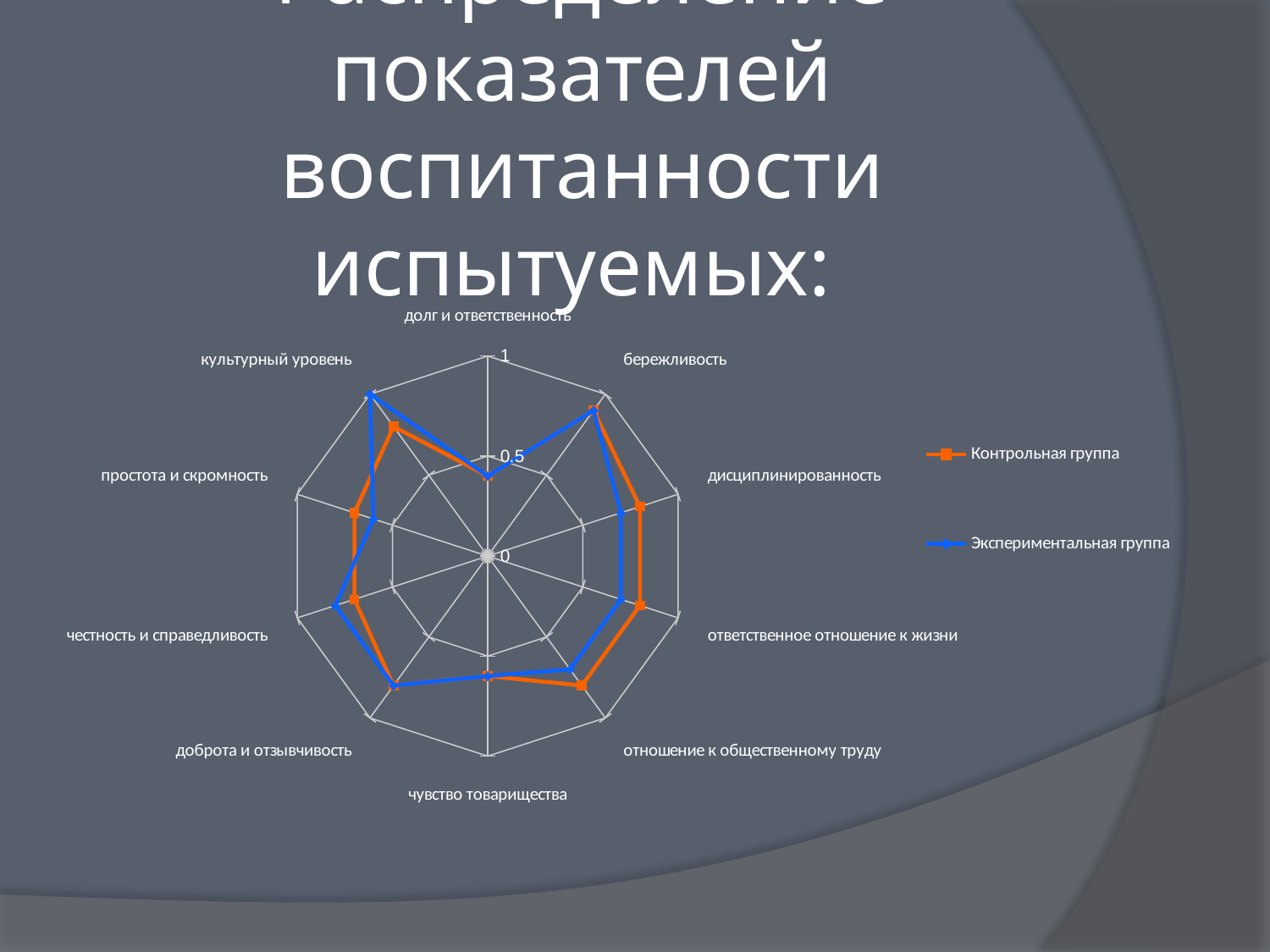
How many series does the legend list? 2 Is the value for долг и ответственность for Контрольная группа greater or less than 0.5? less Is the value for дисциплинированность for Контрольная группа greater or less than 0.5? greater Which category has the highest value for Экспериментальная группа? культурный уровень What kind of chart is shown on the slide? Radar chart Which series is drawn in blue? Экспериментальная группа For отношение к общественному труду, which group has the larger value, Контрольная группа or Экспериментальная группа? Контрольная группа Is the value for бережливость for Экспериментальная группа greater or less than 0.5? greater How many categories (axes) does the radar chart have? 10 For культурный уровень, which group has the larger value, Контрольная группа or Экспериментальная группа? Экспериментальная группа Which category has the lowest value for Контрольная группа? долг и ответственность Which series is drawn in orange? Контрольная группа